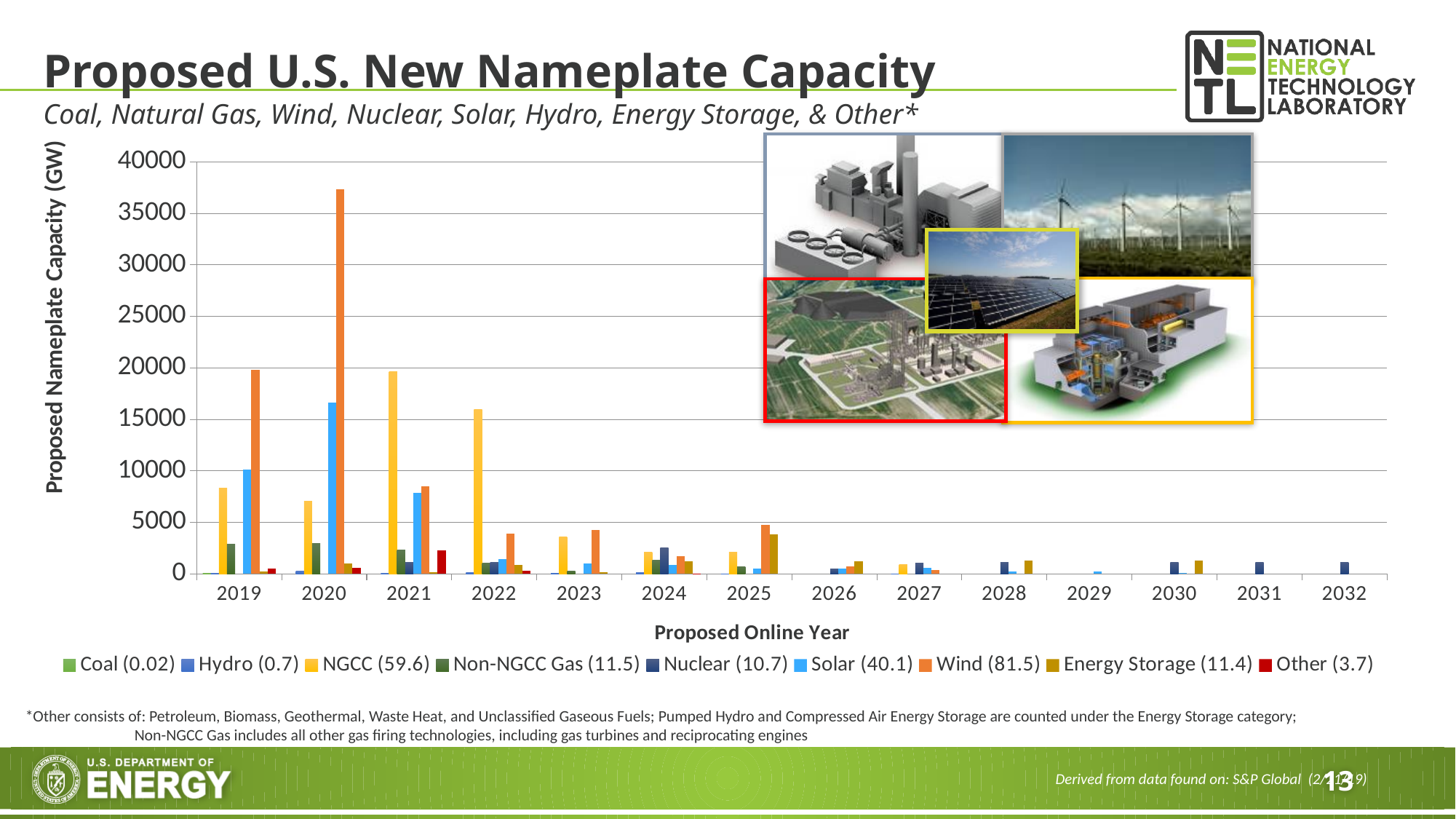
Does the NGCC series rise or fall from 2021 to 2025? fall What value is shown in parentheses next to Wind in the legend? 81.5 Is the value for NGCC in 2021 greater or less than 15000? greater Is the value for Solar in 2020 greater or less than 15000? greater How many series does the legend list? 9 What is the title of the x axis? Proposed Online Year Which series has the tallest bar in 2020? Wind Is the value for Wind in 2020 greater or less than 35000? greater What kind of chart is shown on the slide? bar chart Which is larger in 2019, the Wind bar or the NGCC bar? Wind In which year does the Wind series reach its highest value? 2020 How many proposed online years are shown on the x axis? 14